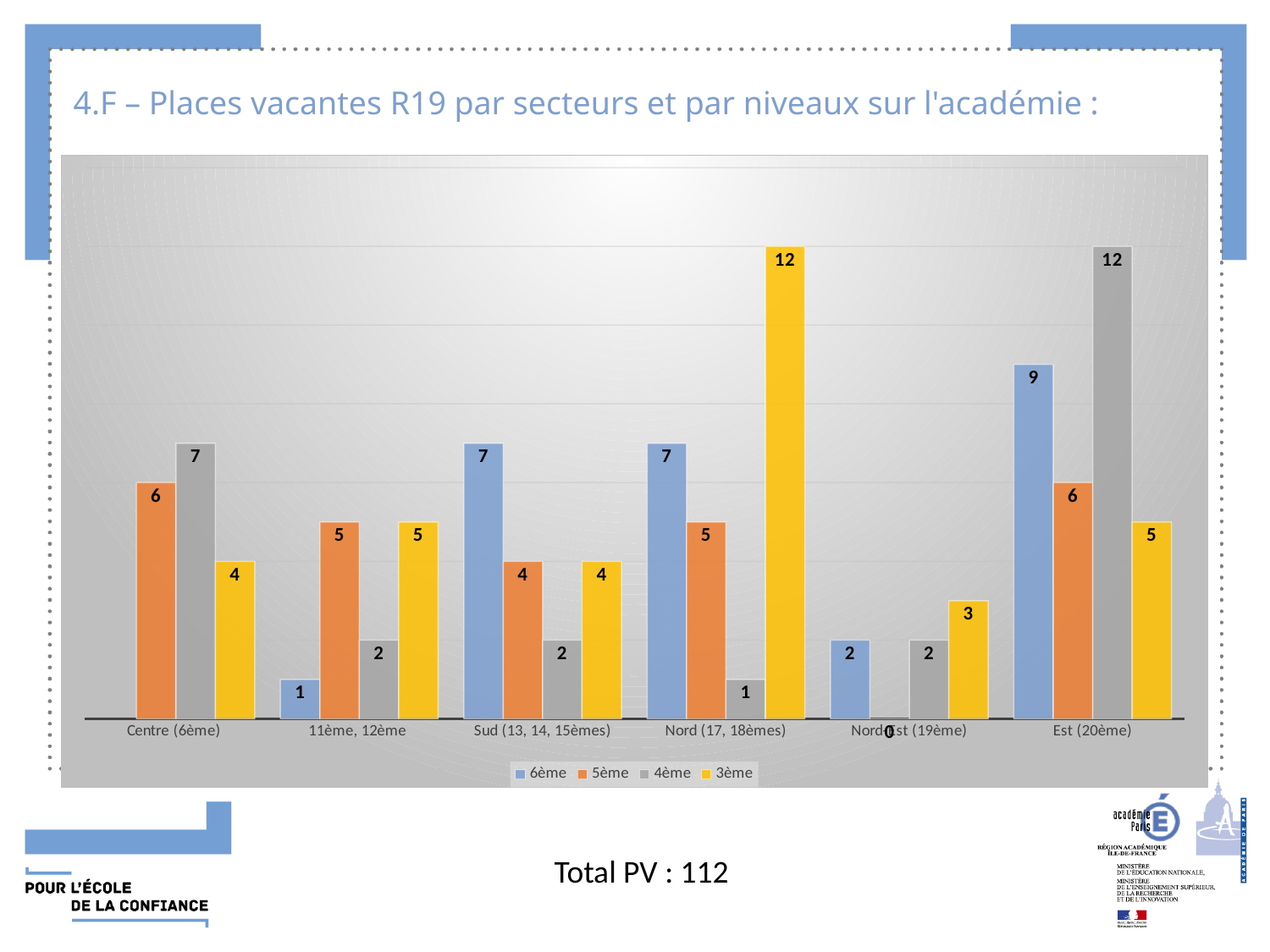
What kind of chart is shown on the slide? Bar chart What is the value for 6ème in the Sud (13, 14, 15èmes) category? 7 Which category has the highest value for the 6ème series? Est (20ème) In the Nord (17, 18èmes) category, which is larger: the 6ème value or the 5ème value? 6ème In the Est (20ème) category, what is the difference between the 6ème value and the 5ème value? 3 What is the value for 5ème in the Centre (6ème) category? 6 What is the value for 4ème in the Est (20ème) category? 12 Which category has the lowest value for the 3ème series? Nord-Est (19ème) How many series does the legend list? 4 What are the entries listed in the chart legend? 6ème, 5ème, 4ème, 3ème How many categories are shown on the x axis? 6 What is the value for 3ème in the Nord (17, 18èmes) category? 12